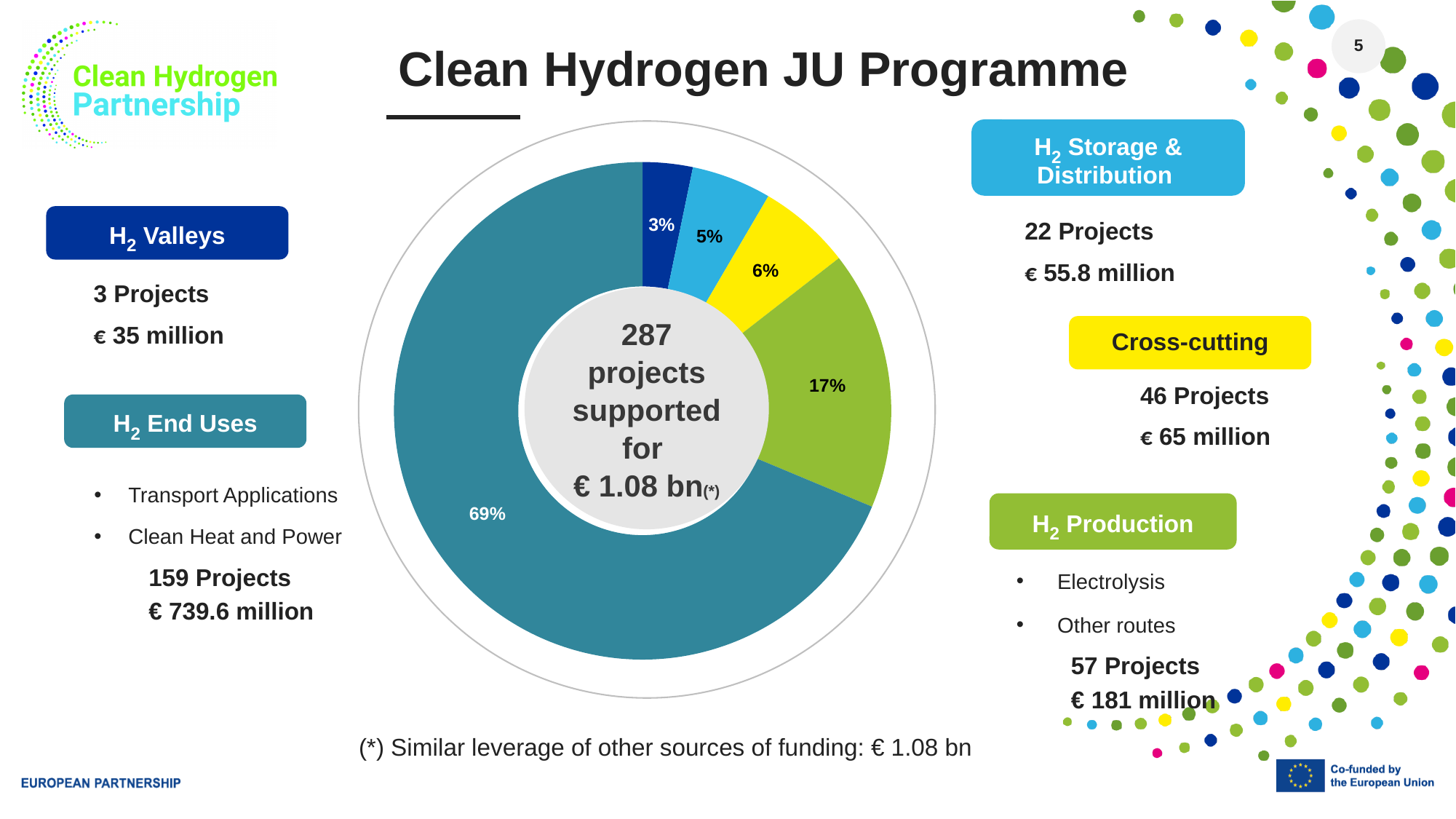
How many slices does the pie chart have? 5 What percentage does the green slice of the pie chart show? 17% Which slice of the pie chart is larger, the yellow slice or the light blue slice? yellow slice What is the title of the slide containing the pie chart? Clean Hydrogen JU Programme What text is written in the centre of the pie chart? 287 projects supported for € 1.08 bn What kind of chart is shown in the centre of the slide? doughnut chart Is the value of the teal slice of the pie chart greater or less than 50%? greater What percentage is shown on the largest slice of the pie chart? 69% What percentage does the light blue slice of the pie chart show? 5% What is the difference in percentage points between the teal slice (69%) and the green slice (17%) of the pie chart? 52 What percentage is shown on the smallest slice of the pie chart? 3% What percentage does the yellow slice of the pie chart show? 6%